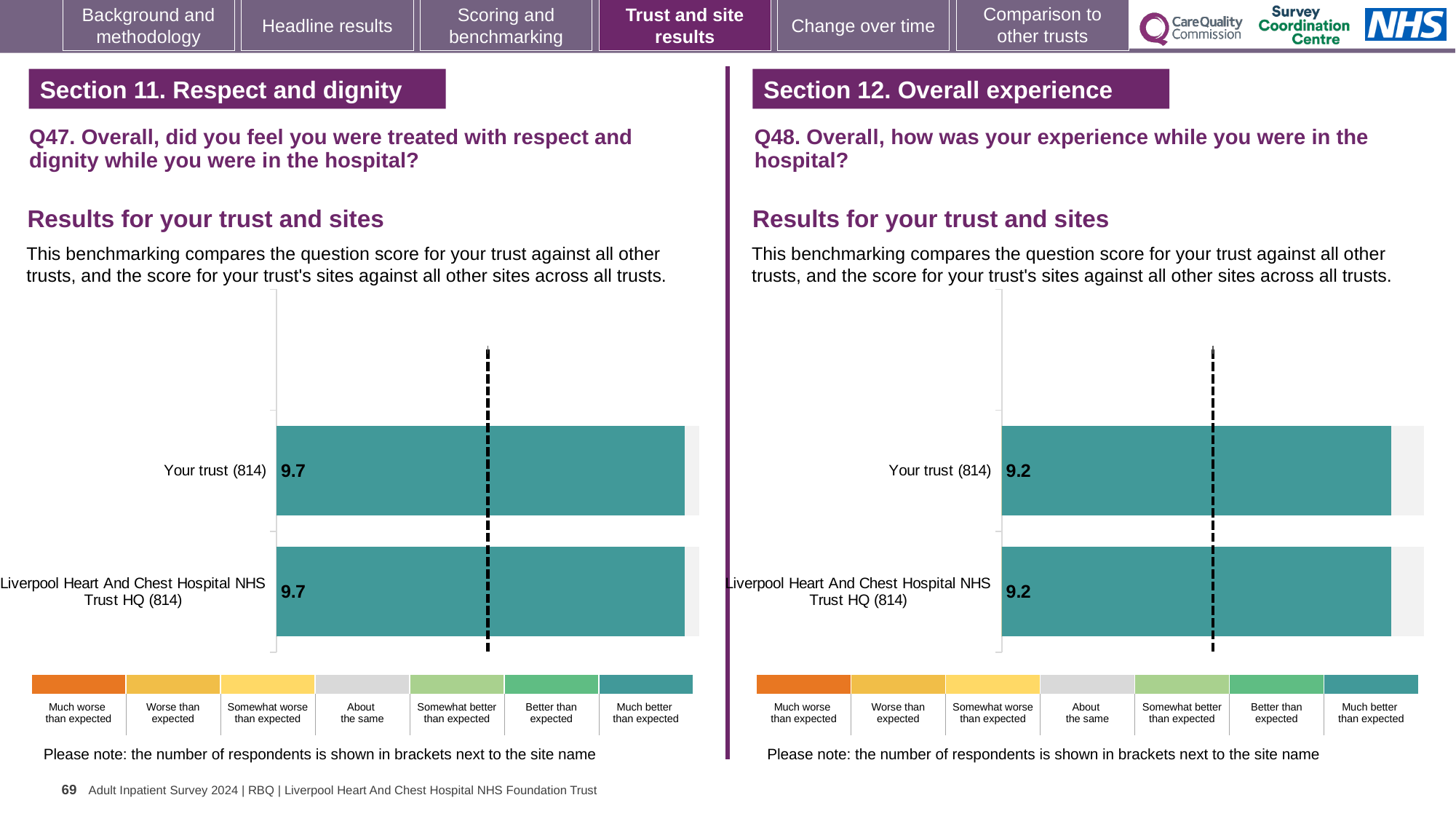
In the Q48 chart on the right, what is the score for Liverpool Heart And Chest Hospital NHS Trust HQ? 9.2 In the Q47 chart on the left, what is the score for Your trust? 9.7 In the Q48 chart on the right, which benchmark category does the colour of the bars correspond to? Much better than expected In the Q47 chart on the left, is the score for Your trust greater or less than the score for Liverpool Heart And Chest Hospital NHS Trust HQ, or are they equal? Equal How many bars are plotted in the Q48 chart on the right? 2 In the Q47 chart on the left, how many respondents are shown in brackets next to Your trust? 814 Which is larger: the Your trust score in the Q47 chart on the left or the Your trust score in the Q48 chart on the right? Q47 chart (9.7) What type of chart is used for the Q47 results on the left? Bar chart What is the difference between the Your trust score in the Q47 chart on the left and the Your trust score in the Q48 chart on the right? 0.5 In the Q47 chart on the left, what is the score for Liverpool Heart And Chest Hospital NHS Trust HQ? 9.7 How many bars are plotted in the Q47 chart on the left? 2 In the Q48 chart on the right, what is the score for Your trust? 9.2